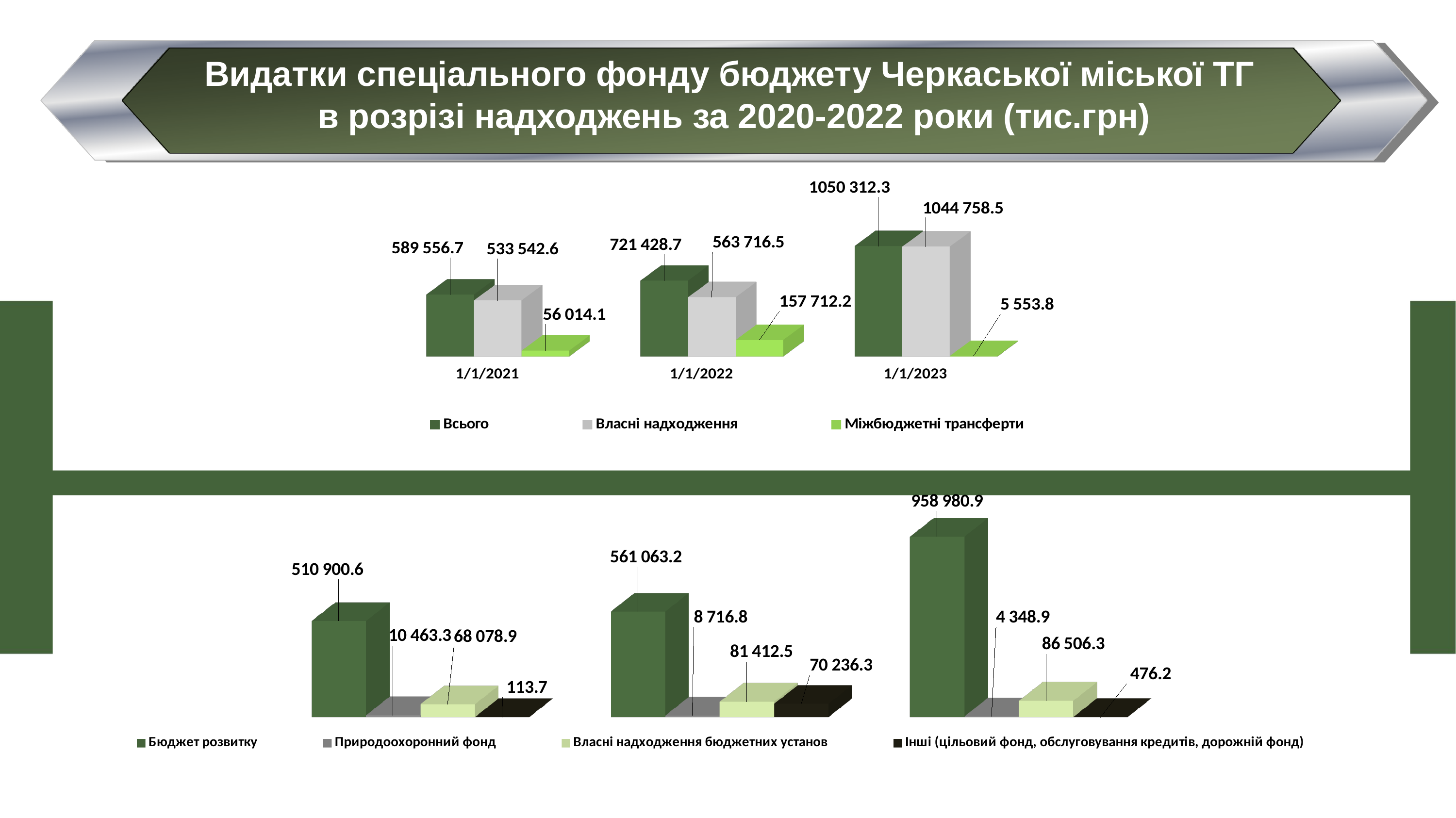
How many series does the legend of the top chart list? 3 In the bottom chart, what is the value of Бюджет розвитку in the rightmost group? 958 980.9 In the top chart, what is the value of Всього for 1/1/2023? 1050 312.3 What kind of chart is the bottom chart? bar chart In the top chart, what is the value of Власні надходження for 1/1/2021? 533 542.6 In the top chart, what is the value of Міжбюджетні трансферти for 1/1/2022? 157 712.2 In the bottom chart, what is the value of Природоохоронний фонд in the middle group? 8 716.8 In the top chart, what is the difference between Всього and Власні надходження for 1/1/2022? 157 712.2 In the top chart, does the value of Всього rise or fall from 1/1/2021 to 1/1/2023? rise In the top chart, which date has the lowest value for Міжбюджетні трансферти? 1/1/2023 In the bottom chart, which is larger in the leftmost group: Власні надходження бюджетних установ or Природоохоронний фонд? Власні надходження бюджетних установ How many series does the legend of the bottom chart list? 4